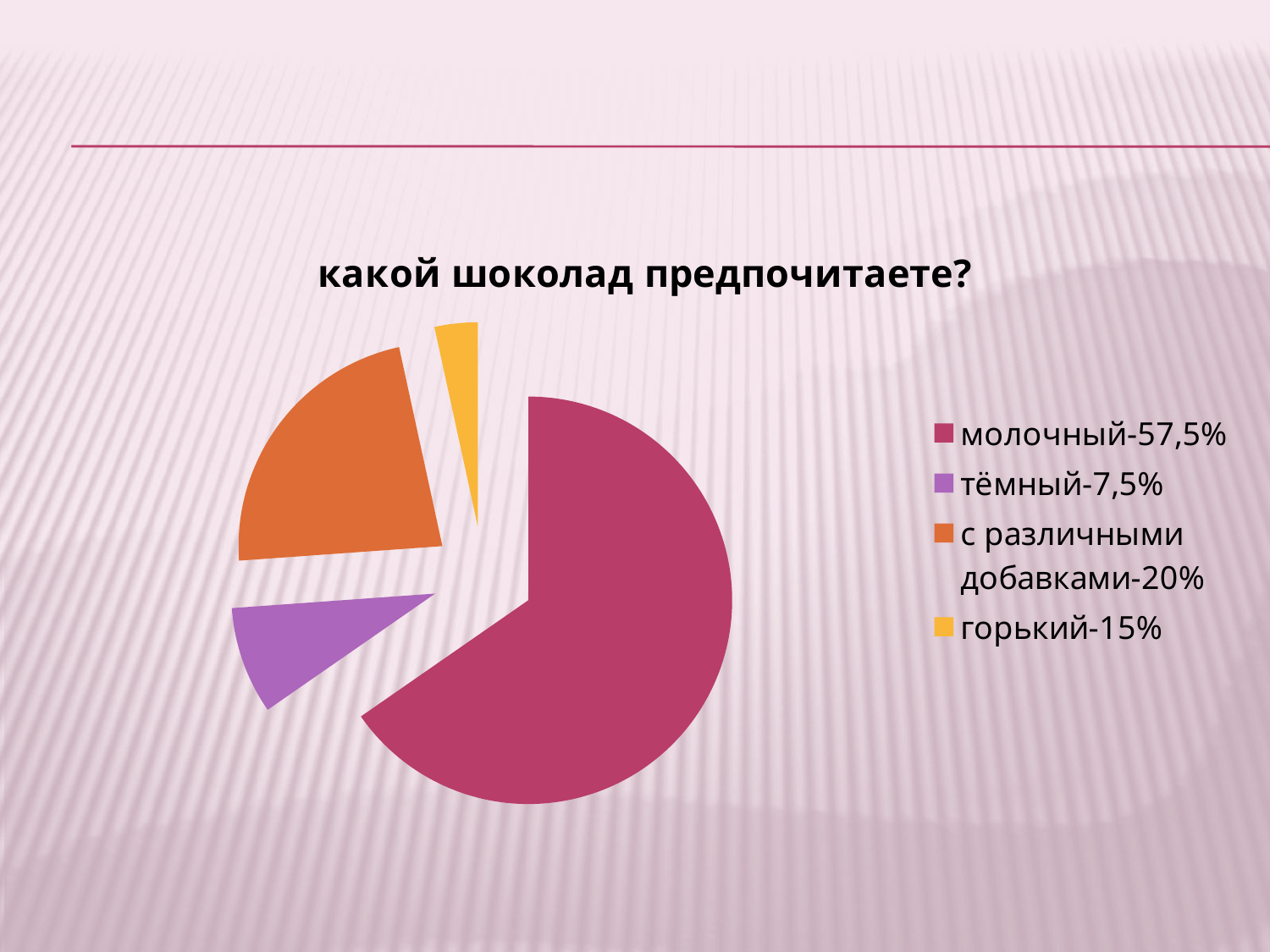
What colour is the slice for горький? yellow What kind of chart is shown on the slide? pie chart Which category has the smallest slice of the pie? горький How many slices does the pie chart have? 4 What share of the pie is молочный? 57,5% What is the title of the chart? какой шоколад предпочитаете? What share of the pie is горький? 15% What share of the pie is тёмный? 7,5% What is the difference between the shares for молочный and с различными добавками? 37,5% Which category has the largest slice of the pie? молочный